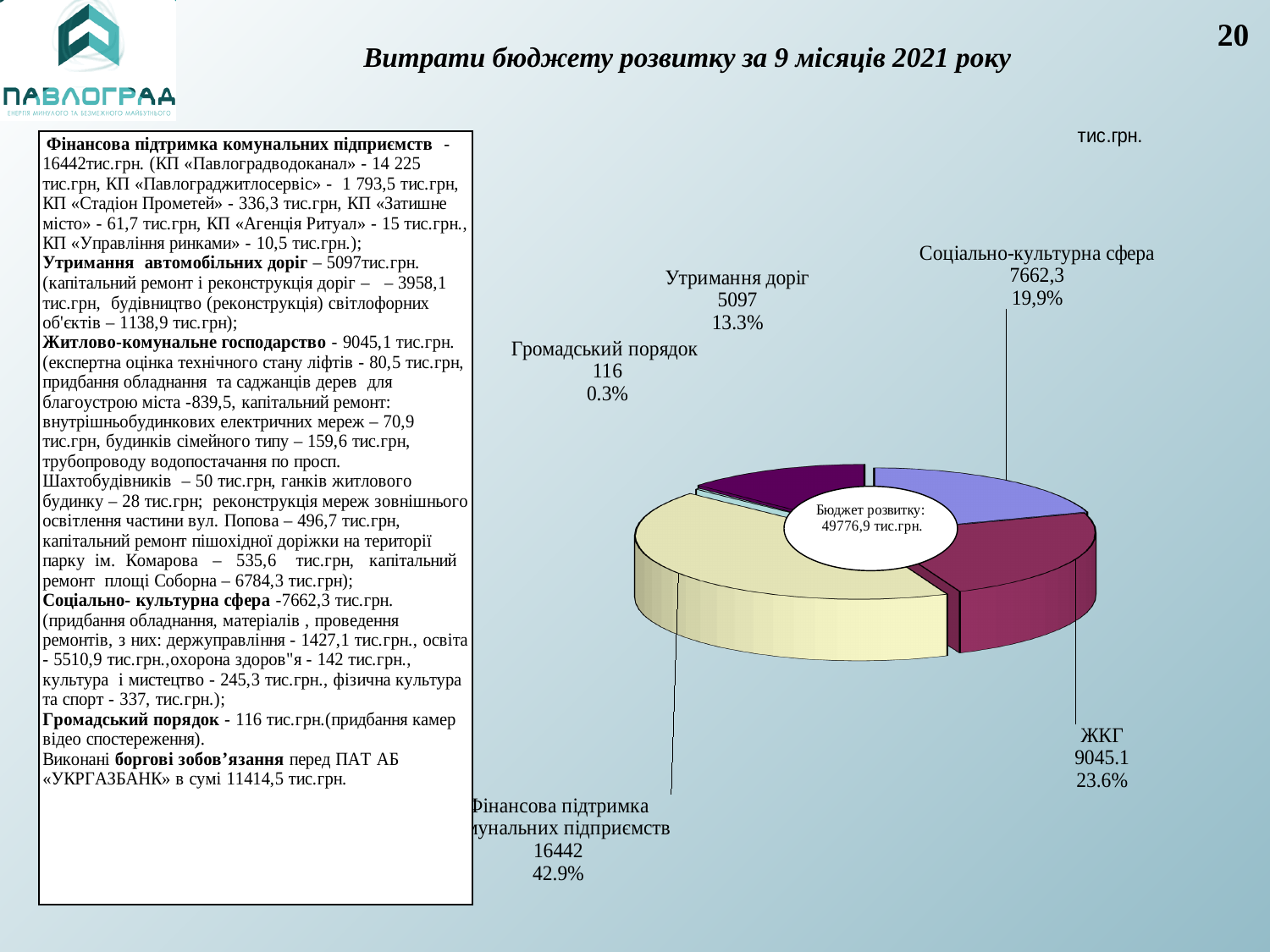
What kind of chart is shown on the slide? pie chart Which category has the largest slice in the pie chart? Фінансова підтримка комунальних підприємств What percentage share does Фінансова підтримка комунальних підприємств have? 42.9% Which category has the smallest slice in the pie chart? Громадський порядок Which is larger: the value for ЖКГ or the value for Соціально-культурна сфера? ЖКГ What percentage share does Громадський порядок have? 0.3% What is the value shown for ЖКГ in the pie chart? 9045.1 What total budget amount is printed in the centre of the pie chart? 49776,9 тис.грн. What is the value shown for Утримання доріг? 5097 What percentage share does Соціально-культурна сфера have in the pie chart? 19,9% How many slices does the pie chart have? 5 What is the difference between the value for Утримання доріг and the value for Громадський порядок? 4981